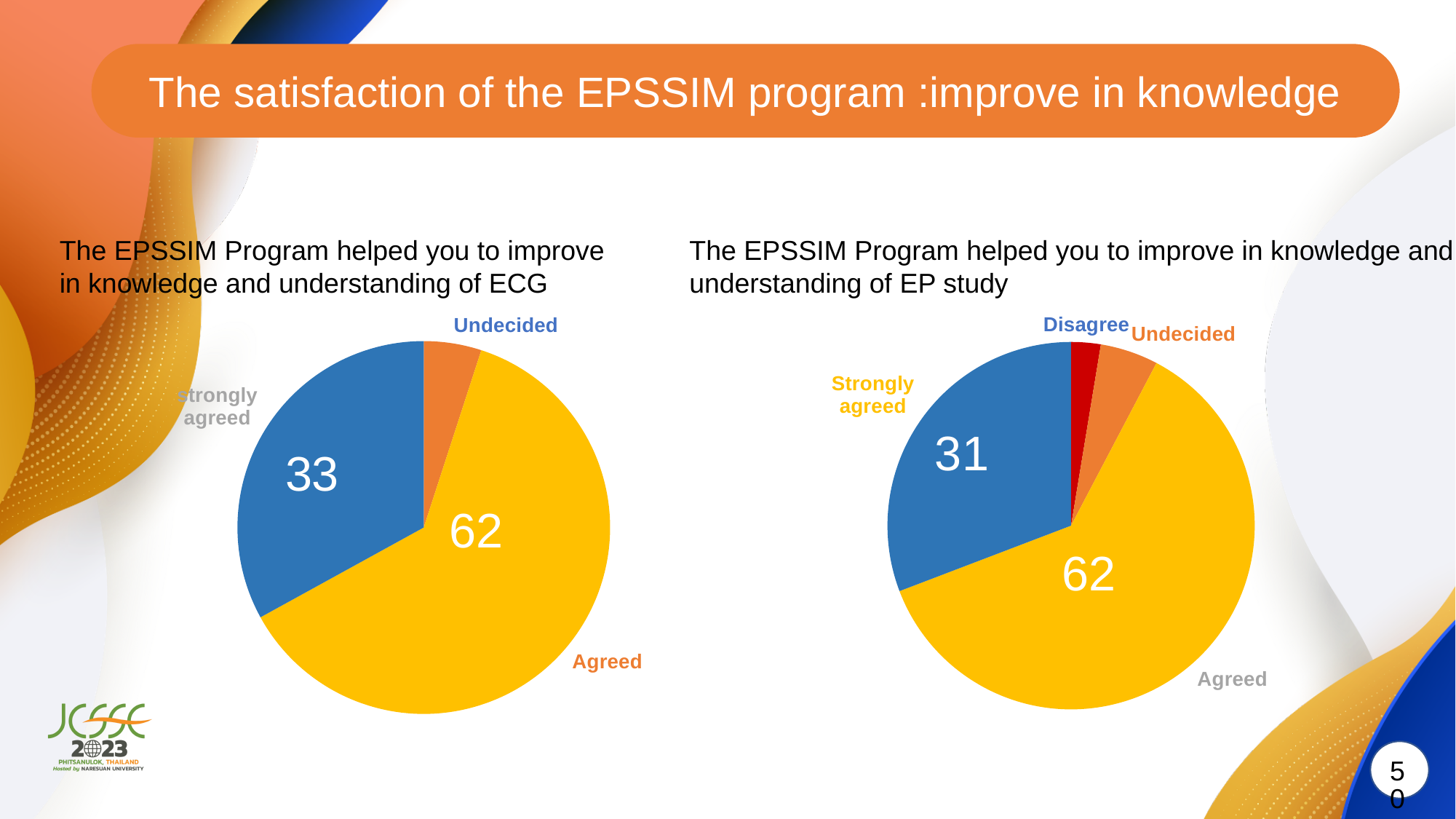
In the ECG chart on the left, which category has the largest slice? Agreed In the EP study chart on the right, what value is shown for the Agreed slice? 62 In the EP study chart on the right, which category has the smallest slice? Disagree In the EP study chart on the right, what value is shown for the Strongly agreed slice? 31 In the ECG chart on the left, what is the difference between the Agreed and strongly agreed values? 29 In the ECG chart on the left, what value is shown for the Agreed slice? 62 In the EP study chart on the right, what is the difference between the Agreed and Strongly agreed values? 31 In the ECG chart on the left, what value is shown for the strongly agreed slice? 33 In the EP study chart on the right, which is larger: Strongly agreed or Undecided? Strongly agreed How many slices does the EP study chart on the right have? 4 In the ECG chart on the left, which category has the smallest slice? Undecided What type of chart is used for the ECG chart on the left? Pie chart